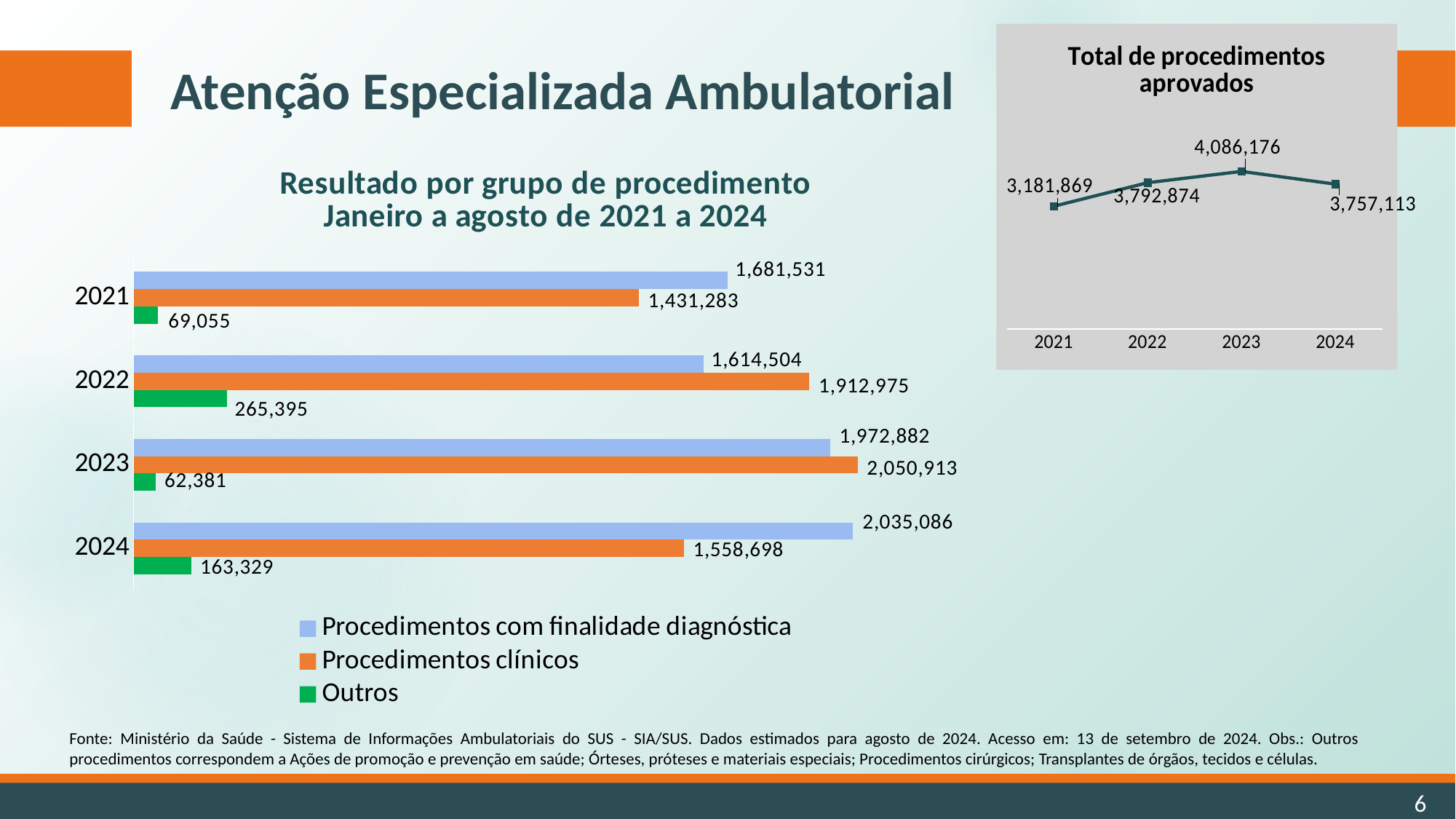
In the chart 'Resultado por grupo de procedimento', which is larger in 2023: Procedimentos com finalidade diagnóstica or Procedimentos clínicos? Procedimentos clínicos In the chart 'Resultado por grupo de procedimento', which year has the highest value for Procedimentos com finalidade diagnóstica? 2024 In the chart 'Total de procedimentos aprovados', which year has the lowest value? 2021 What kind of chart is 'Resultado por grupo de procedimento'? Bar chart In the chart 'Total de procedimentos aprovados', what is the value for 2023? 4,086,176 How many series does the legend of the chart 'Resultado por grupo de procedimento' list? 3 In the chart 'Resultado por grupo de procedimento', what is the difference between Procedimentos clínicos and Procedimentos com finalidade diagnóstica in 2021? 250,248 In the chart 'Resultado por grupo de procedimento', which year has the lowest value for Outros? 2023 In the chart 'Resultado por grupo de procedimento', what is the value for Outros in 2024? 163,329 What kind of chart is 'Total de procedimentos aprovados'? Line chart In the chart 'Resultado por grupo de procedimento', what is the value for Procedimentos clínicos in 2022? 1,912,975 In the chart 'Total de procedimentos aprovados', what is the difference between the 2023 and 2024 values? 329,063